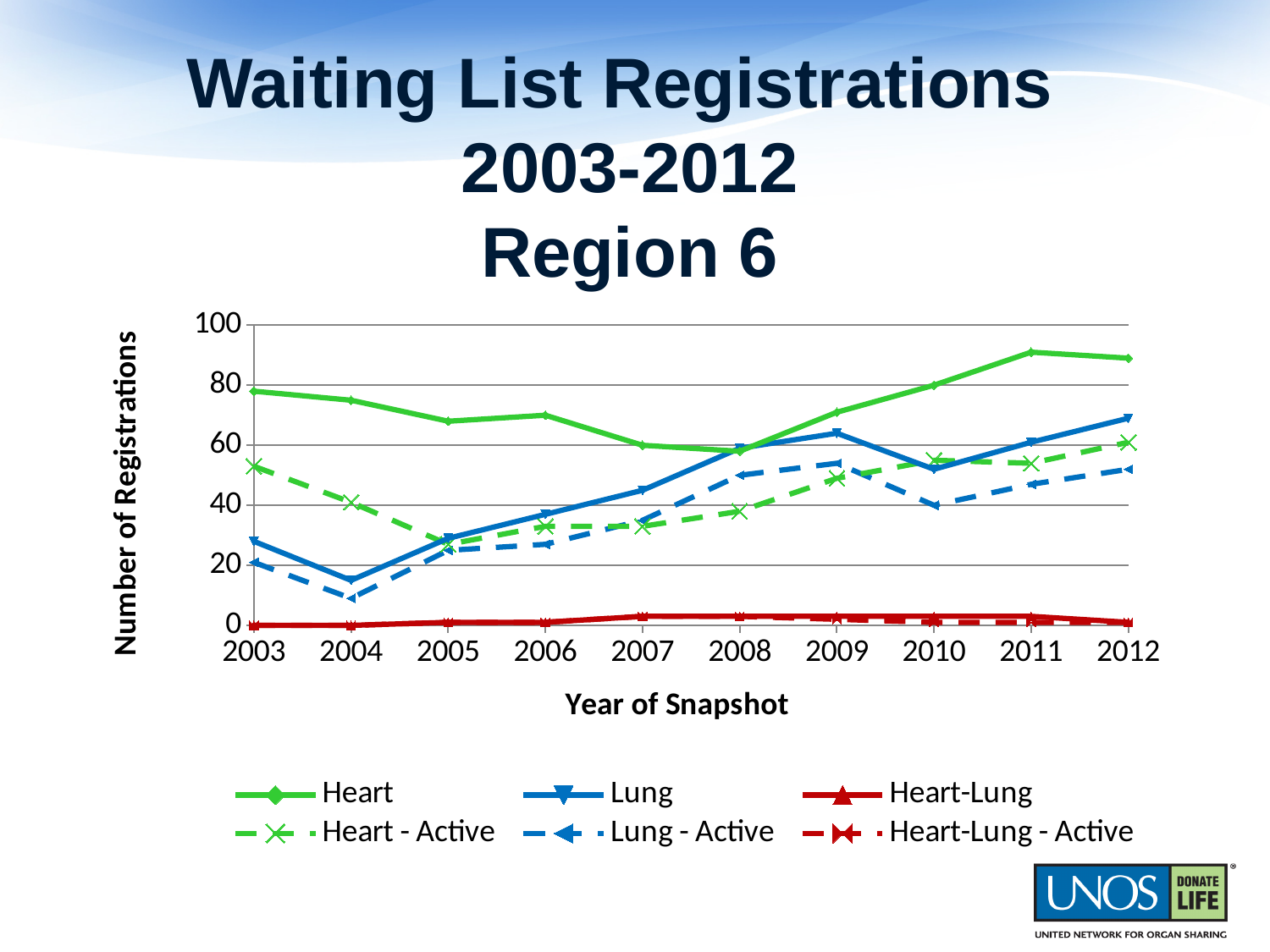
Is the value for Lung - Active in 2004 greater or less than 20? less In which year is the Lung series at its lowest? 2004 Is the value for Heart in 2011 greater or less than 80? greater Is the value for Lung in 2004 greater or less than 20? less What is the title of the x axis? Year of Snapshot How many series does the legend list? 6 What kind of chart is shown on the slide? line chart In 2003, which series has the larger value, Heart or Lung? Heart Does the Lung series rise or fall from 2004 to 2009? rise How many years are plotted along the x axis? 10